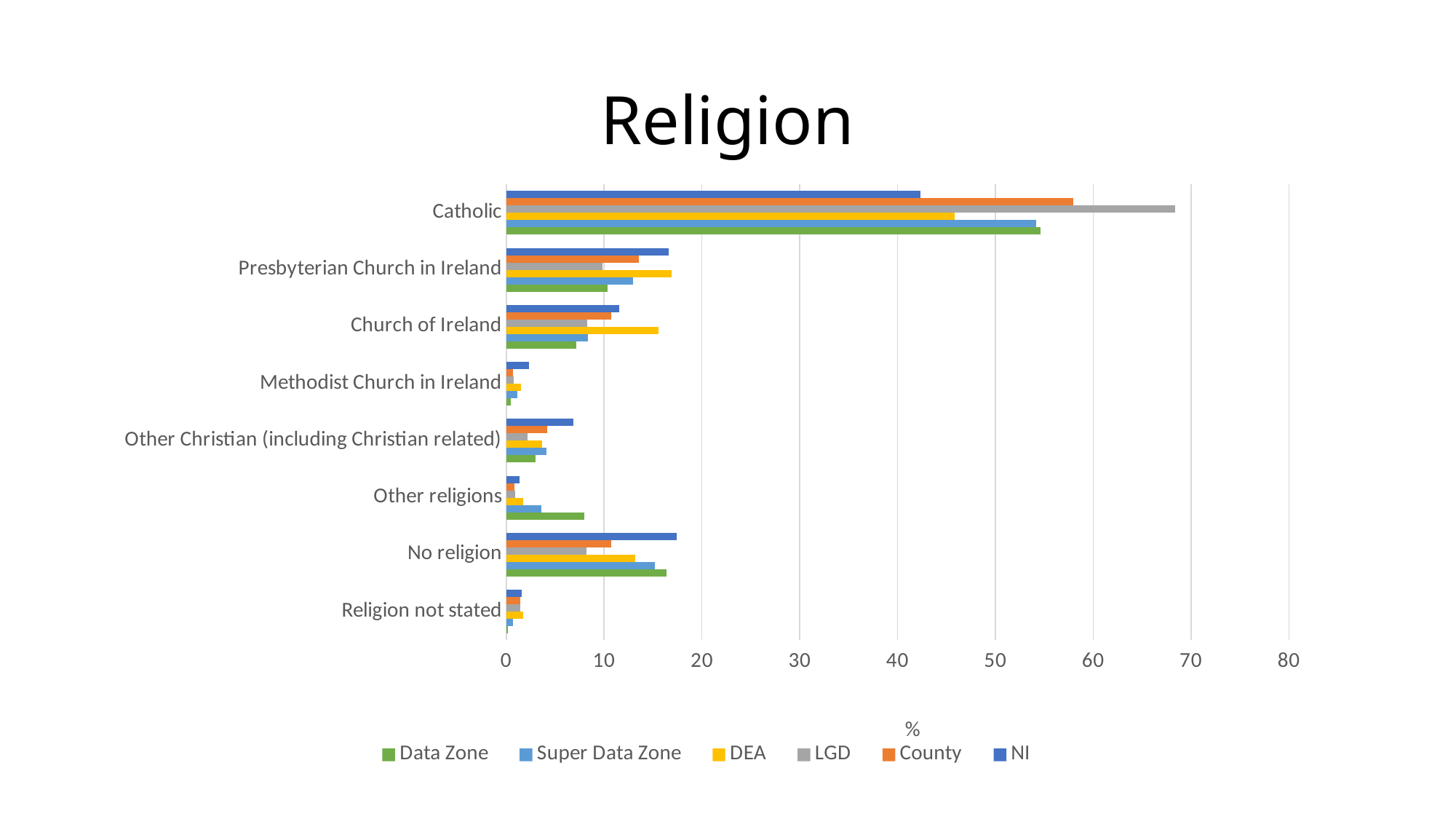
What label is shown on the horizontal axis? % Is the LGD value for Catholic greater or less than 60? greater Is the NI value for No religion greater or less than 10? greater Which is larger for Other religions: the Data Zone value or the NI value? Data Zone Which series has the lowest value for the Catholic category? NI Which category has the highest value for the LGD series? Catholic Which series has the highest value for the Catholic category? LGD How many religion categories are shown on the chart? 8 How many series does the legend list? 6 Is the NI value for Catholic greater or less than 50? less What kind of chart is shown on the slide? Bar chart What is the title of the chart? Religion